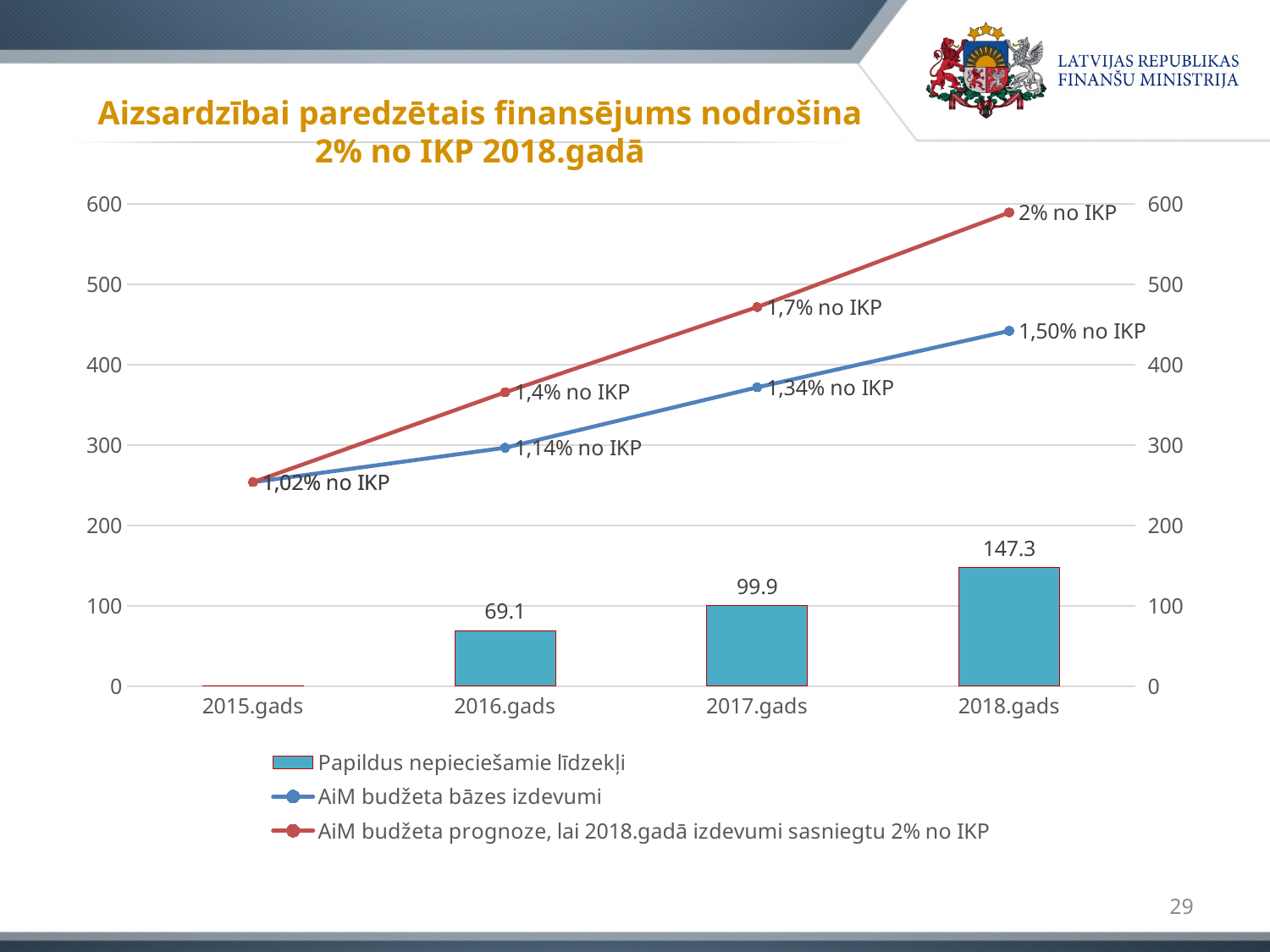
Which is larger, the Papildus nepieciešamie līdzekļi bar for 2016.gads or for 2017.gads? 2017.gads What is the value of the Papildus nepieciešamie līdzekļi bar for 2016.gads? 69.1 How many series does the legend list? 3 What is the difference between the Papildus nepieciešamie līdzekļi values for 2018.gads and 2017.gads? 47.4 Is the value of the AiM budžeta bāzes izdevumi line for 2017.gads greater or less than 400? less Which year has the highest Papildus nepieciešamie līdzekļi bar? 2018.gads Is the value of the AiM budžeta prognoze line for 2018.gads greater or less than 500? greater Do the Papildus nepieciešamie līdzekļi bars rise or fall from 2016.gads to 2018.gads? rise What label is shown on the AiM budžeta prognoze line at 2017.gads? 1,7% no IKP How many years are shown on the x axis? 4 What is the value of the Papildus nepieciešamie līdzekļi bar for 2018.gads? 147.3 What is the value of the Papildus nepieciešamie līdzekļi bar for 2017.gads? 99.9